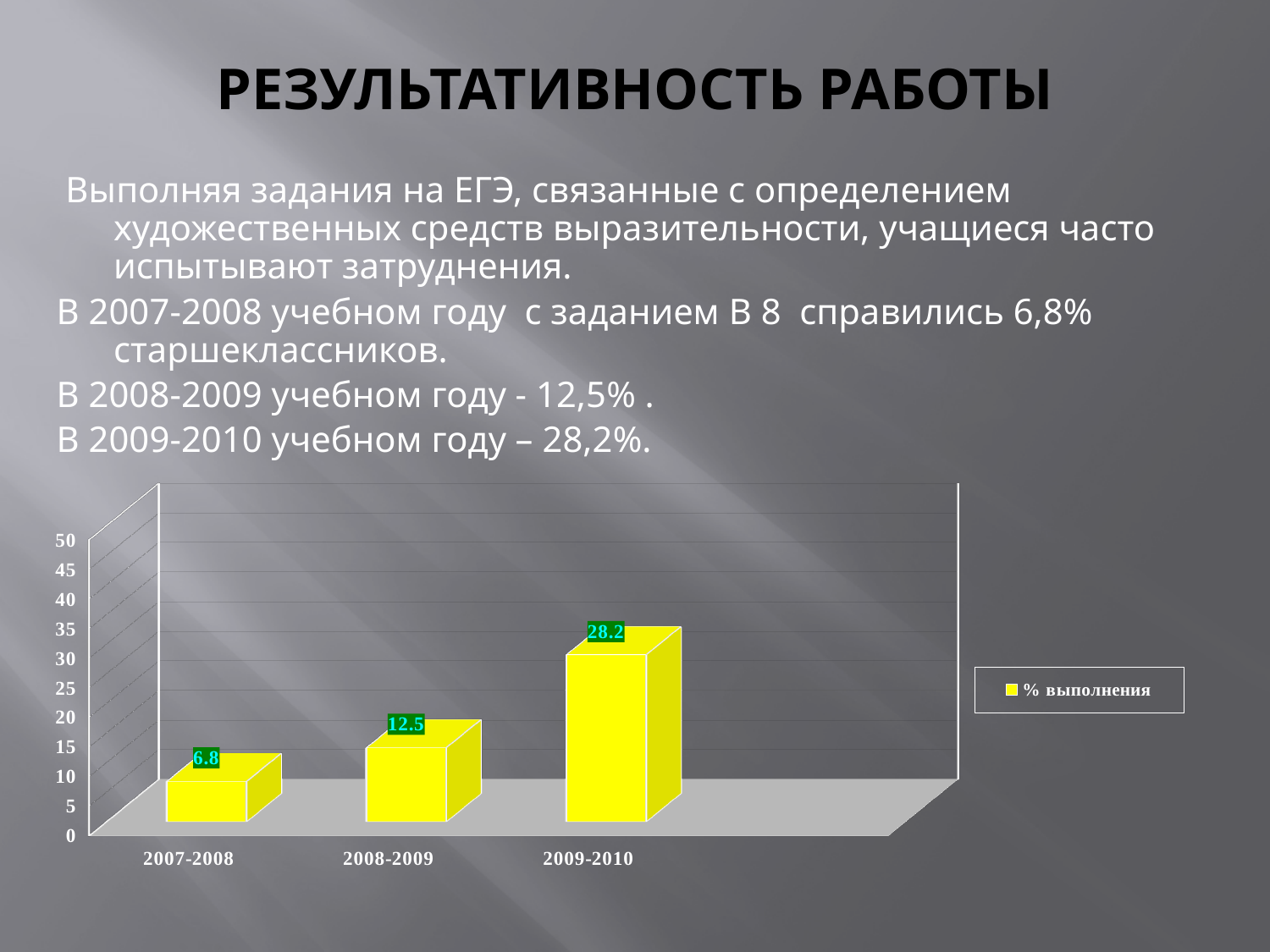
Which is larger, the value for 2008-2009 or the value for 2007-2008? 2008-2009 What kind of chart is shown? bar chart What is the value for 2007-2008? 6.8 What is the value for 2008-2009? 12.5 Which year has the highest value? 2009-2010 How many series does the legend list? 1 Do the values rise or fall from 2007-2008 to 2009-2010? rise What is the difference between the values for 2008-2009 and 2007-2008? 5.7 What is the value for 2009-2010? 28.2 What is the difference between the values for 2009-2010 and 2008-2009? 15.7 How many categories are shown on the x axis? 3 Which year has the lowest value? 2007-2008